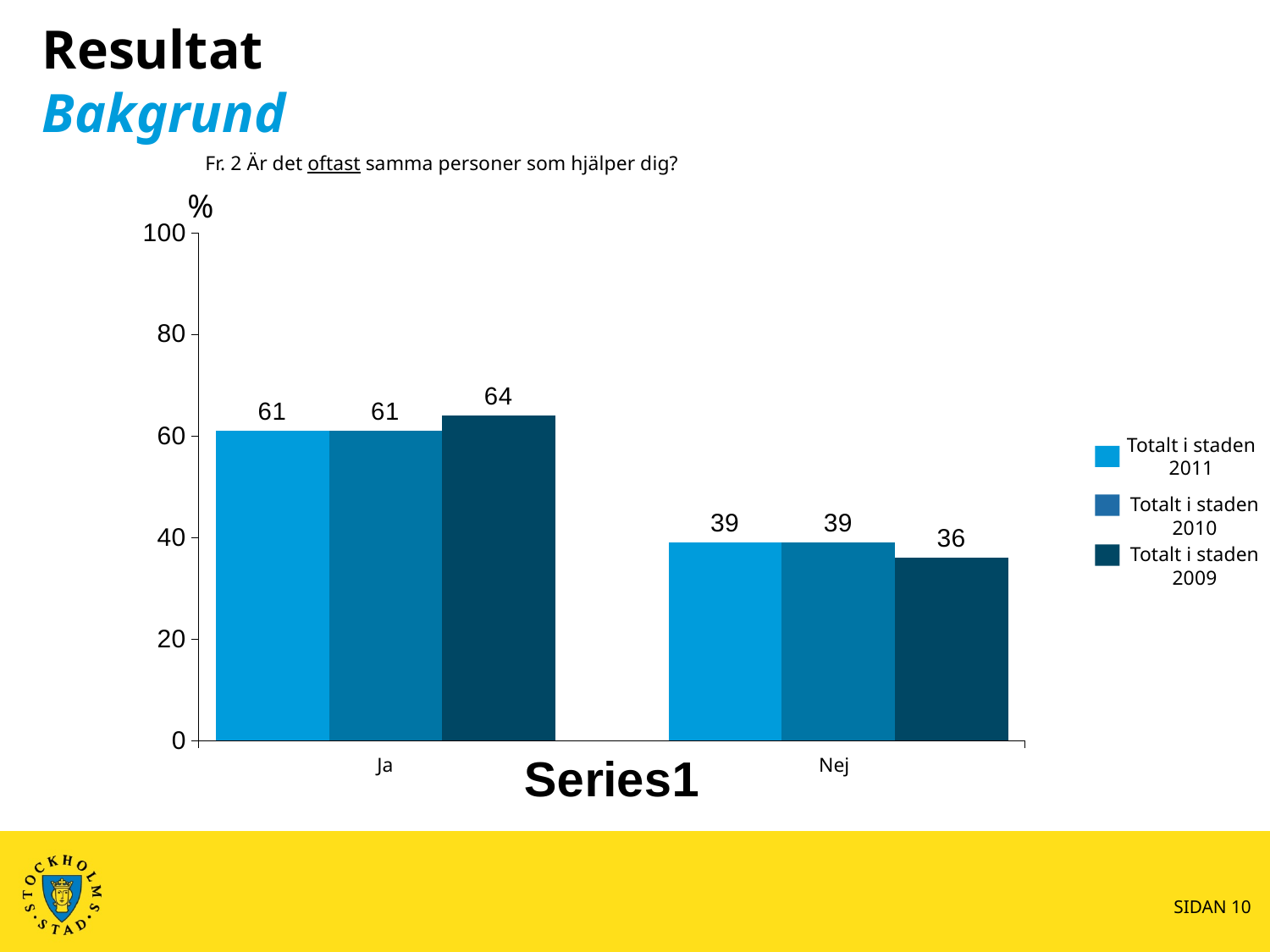
What is the value for Ja in the Totalt i staden 2011 series? 61 How many series does the legend list? 3 What kind of chart is shown on the slide? Bar chart What is the value for Nej in the Totalt i staden 2009 series? 36 Which category has the highest value in the Totalt i staden 2009 series? Ja What question is the chart about, as stated above it? Fr. 2 Är det oftast samma personer som hjälper dig? What is the value for Nej in the Totalt i staden 2010 series? 39 Which category has the lowest value in the Totalt i staden 2011 series? Nej What is the difference between the Ja and Nej values in the Totalt i staden 2009 series? 28 What is the value for Ja in the Totalt i staden 2009 series? 64 How many categories are shown on the x axis? 2 Which is larger: the Ja value for Totalt i staden 2009 or the Ja value for Totalt i staden 2011? Totalt i staden 2009